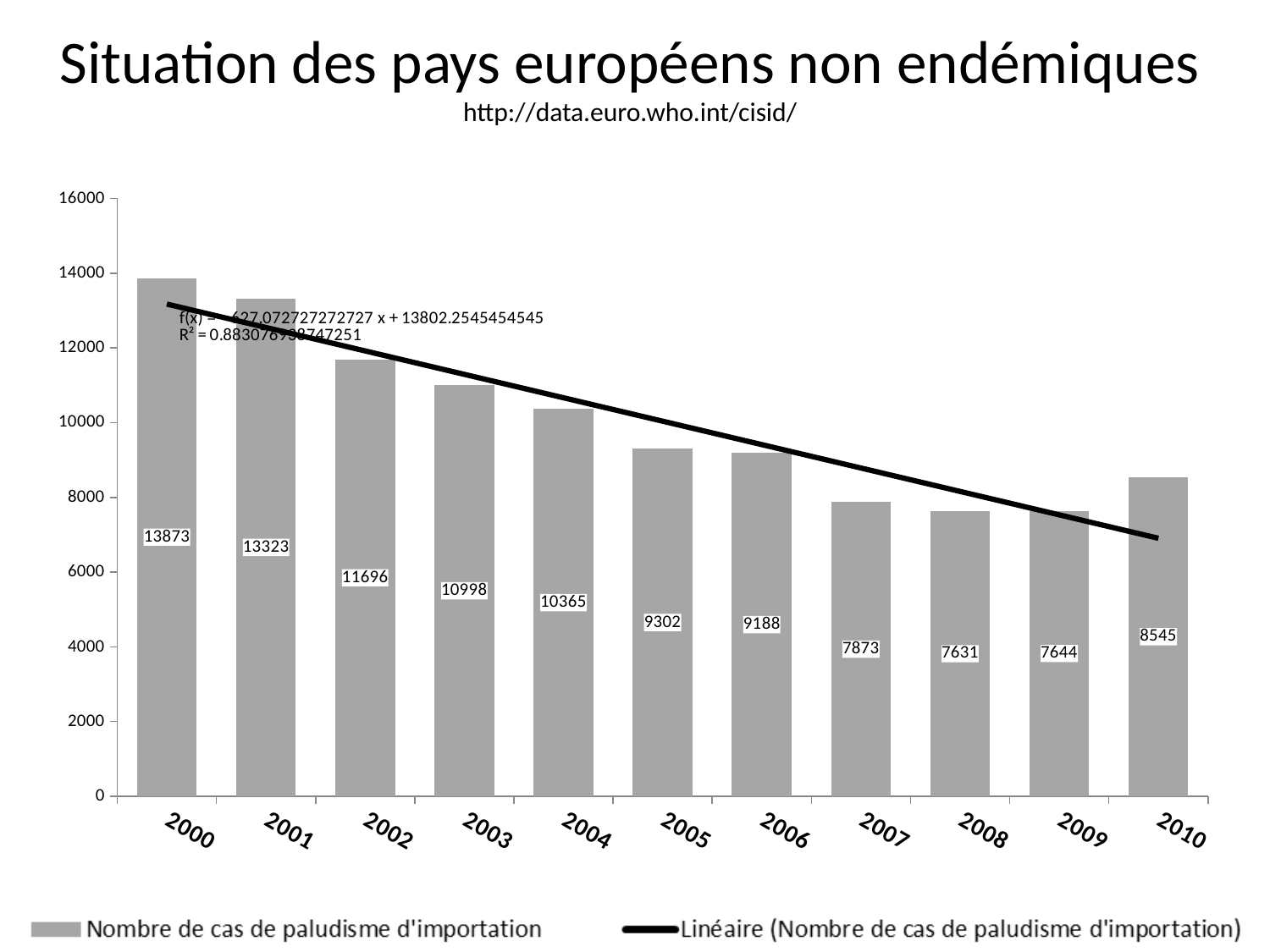
What is the number of imported malaria cases shown for 2000? 13873 What is the difference between the values for 2005 and 2006? 114 How many entries does the legend list? 2 Which year has the larger value, 2003 or 2004? 2003 Which year has the lowest labelled value? 2008 How many years are shown on the x axis? 11 What kind of chart is shown on the slide? bar chart Which year has the highest bar? 2000 What is the difference between the values for 2000 and 2010? 5328 Is the value for 2007 greater or less than 8000? less What value is labelled on the bar for 2010? 8545 What value is labelled on the bar for 2005? 9302